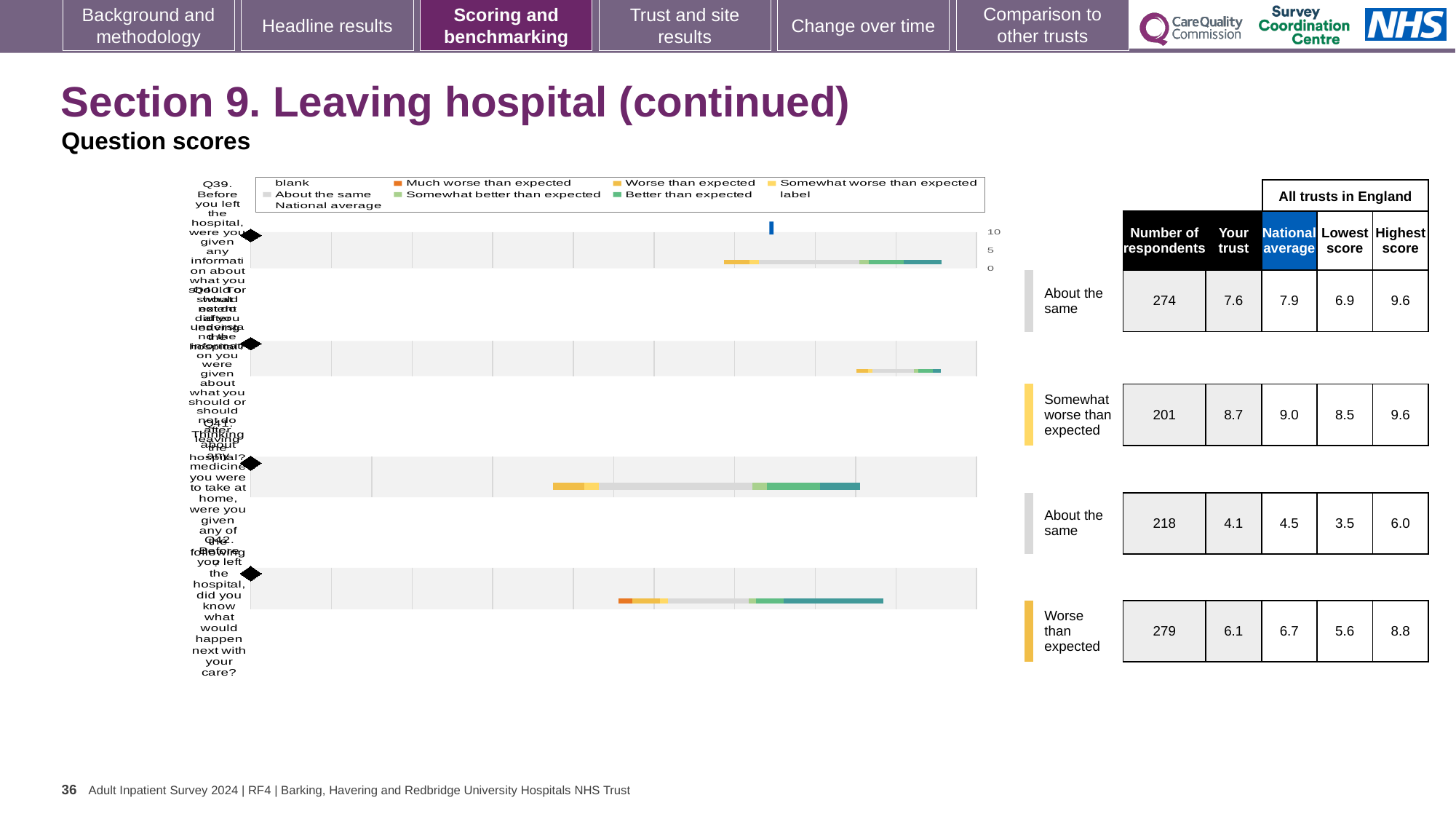
In the table beside the chart, for the row labelled 'Somewhat worse than expected', which is larger: the 'Your trust' score or the national average? National average In the chart legend, what colour represents 'Much worse than expected'? orange In the table beside the chart, which row has the largest number of respondents? Worse than expected (279) In the table beside the chart, how many respondents are shown for the row labelled 'Somewhat worse than expected'? 201 In the table beside the chart, what is the highest score in England for the row labelled 'Somewhat worse than expected'? 9.6 What kind of chart is shown on the slide? bar chart In the chart legend, what colour represents 'Better than expected'? teal green How many questions (Q39 to Q42) are plotted as rows in the chart? 4 In the table beside the chart, what is the 'Your trust' score for the row labelled 'Worse than expected'? 6.1 In the table beside the chart, what is the difference between the national average and the 'Your trust' score for the row labelled 'Worse than expected'? 0.6 In the table beside the chart, what is the lowest 'Your trust' score shown? 4.1 In the table beside the chart, what is the national average for the row labelled 'Worse than expected'? 6.7